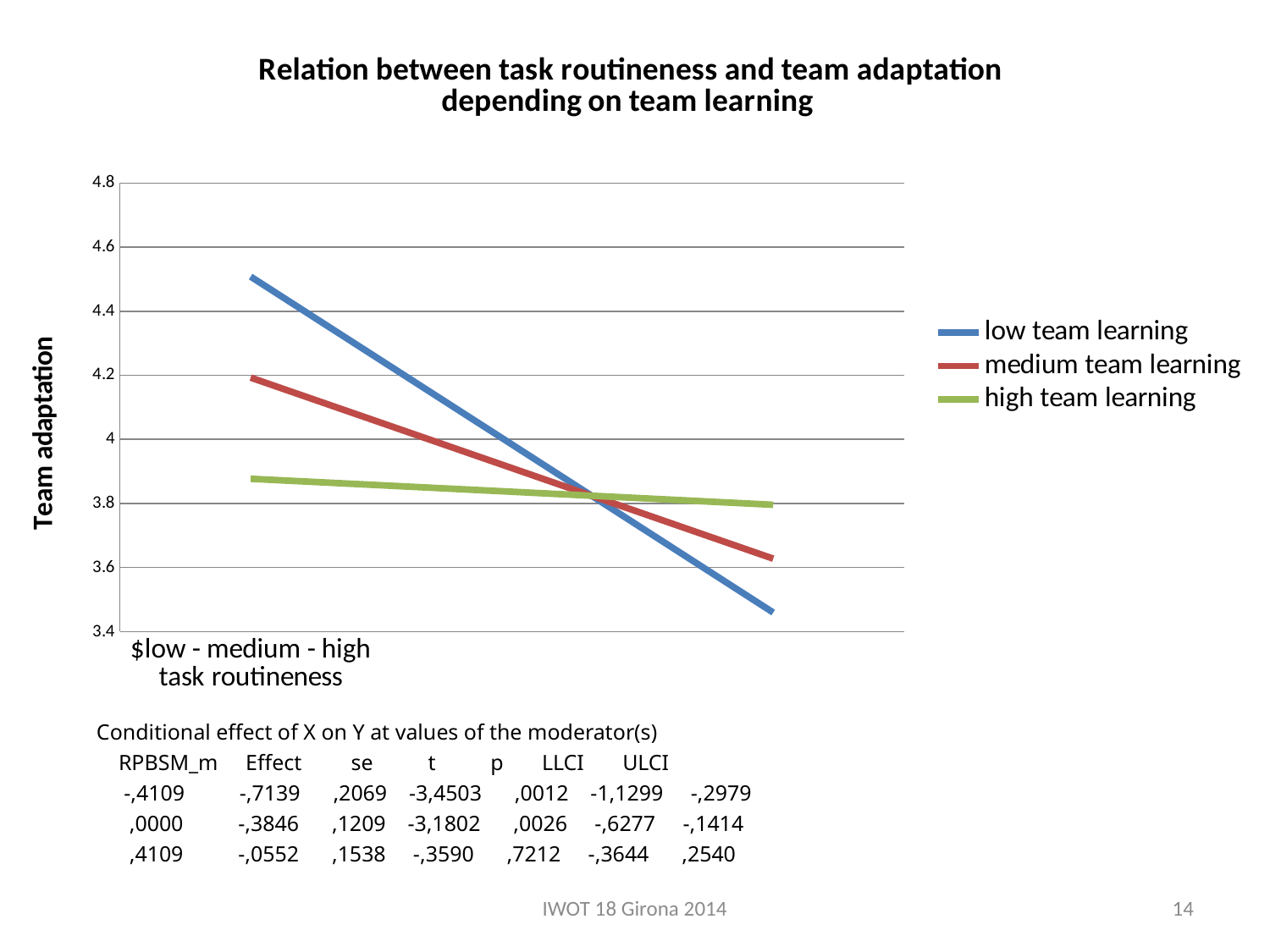
Does the high team learning line rise or fall as task routineness increases? fall Which series has the steepest decline across the x axis? low team learning What kind of chart is shown on the slide? line chart At the left end of the chart, is the value for high team learning greater or less than 4? less Which series has the lowest team adaptation value at the right end (high task routineness)? low team learning Which series has the highest team adaptation value at the left end (low task routineness)? low team learning How many series does the legend list? 3 At the right end of the chart, is the value for low team learning greater or less than 3.6? less What is the title of the chart? Relation between task routineness and team adaptation depending on team learning What is the label of the vertical axis? Team adaptation At the left end of the chart, is the value for low team learning greater or less than 4.4? greater Does the low team learning line rise or fall as task routineness increases? fall